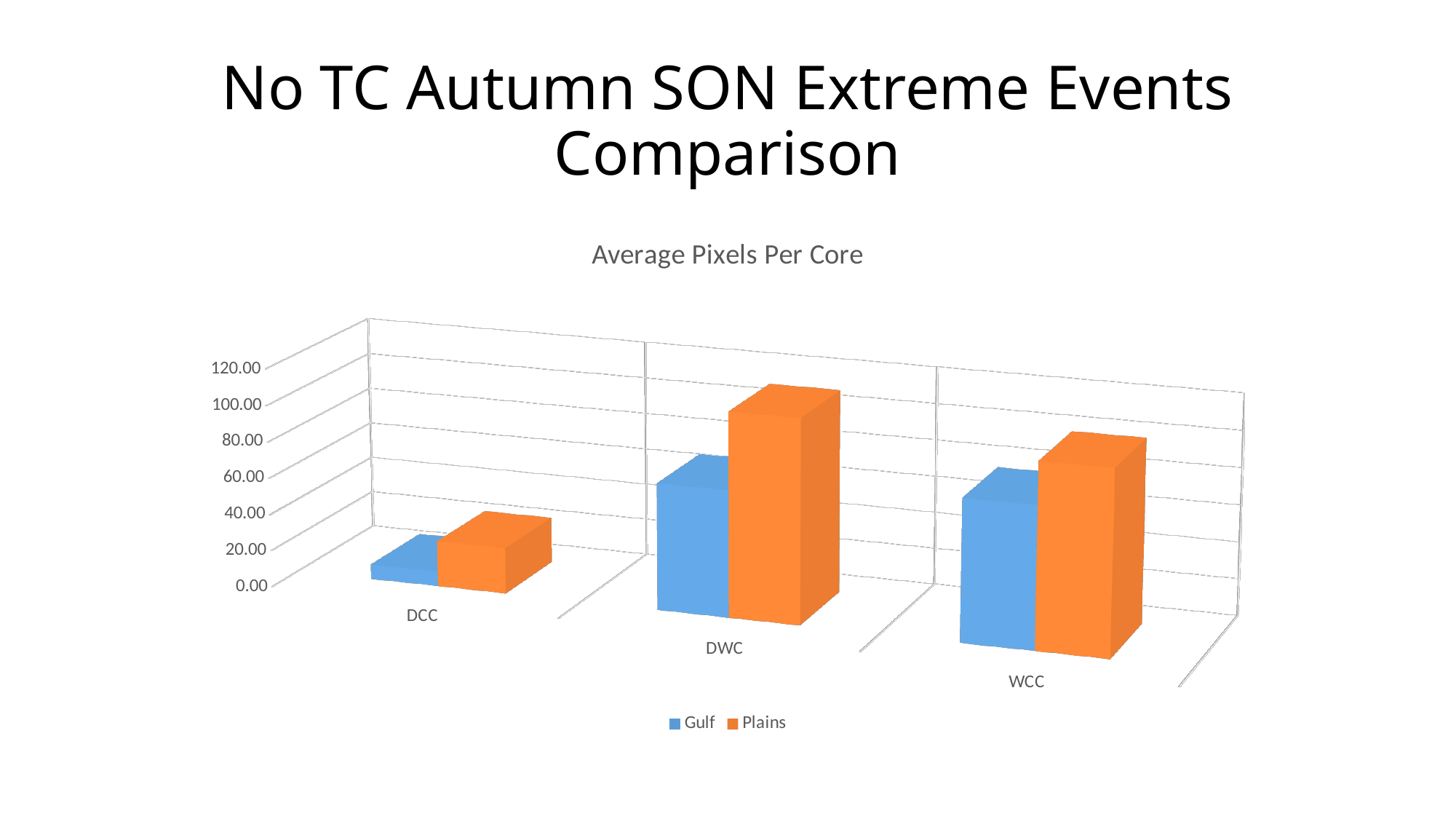
Which category has the highest Plains value? DWC Which series is shown in orange in the chart? Plains Is the Gulf value for DCC greater or less than 40.00? less How many categories are shown on the x axis of the chart? 3 Which category has the lowest Gulf value? DCC Which category has the larger Gulf value, DWC or WCC? WCC How many series does the legend list? 2 What is the title of the chart? Average Pixels Per Core Is the Plains value for DWC greater or less than 60.00? greater For DWC, which series has the larger value, Gulf or Plains? Plains Is the Plains value for WCC greater or less than 40.00? greater What kind of chart is shown on the slide? bar chart